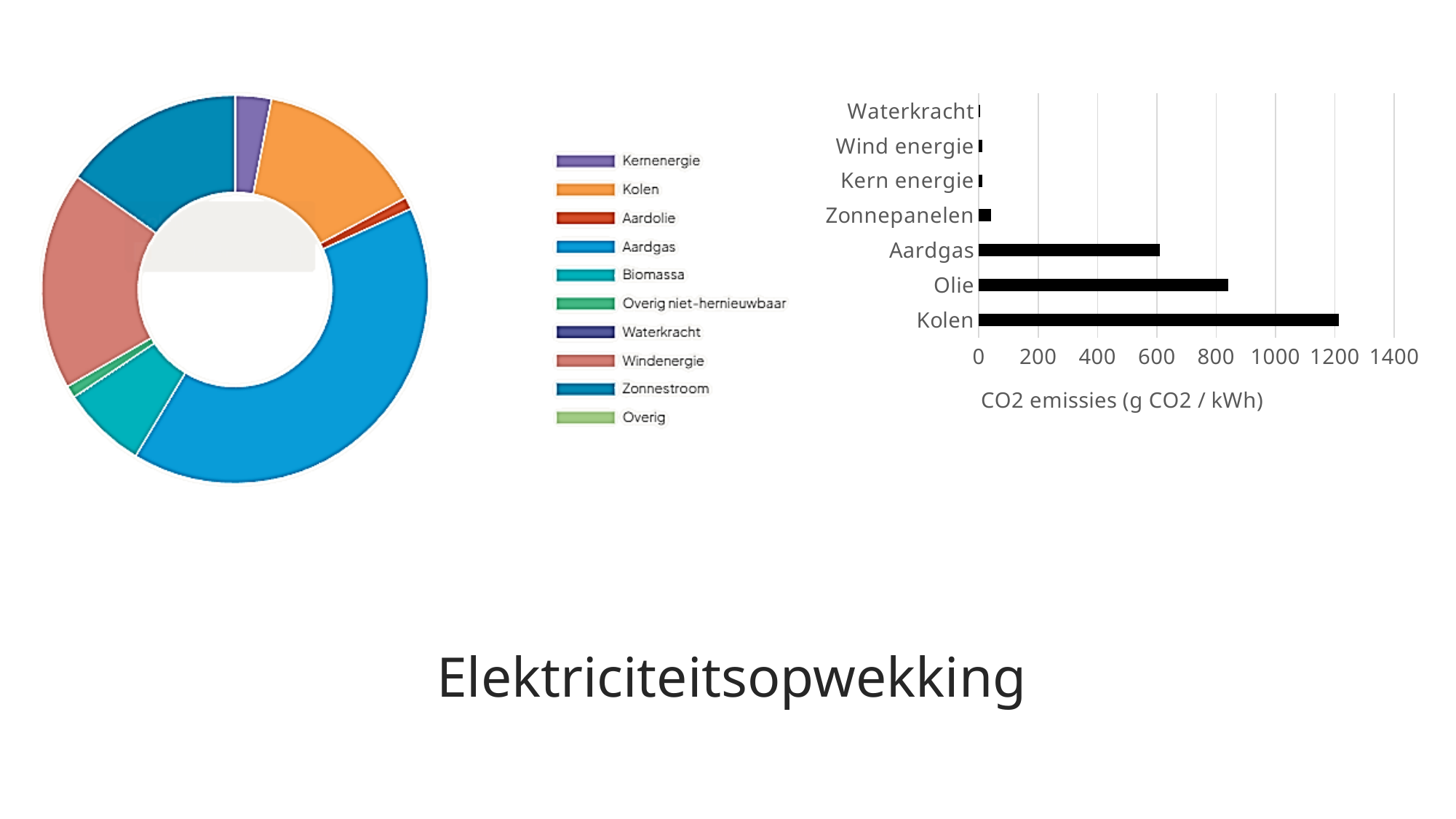
How many categories does the bar chart on the right show? 7 In the bar chart on the right, is the value for Zonnepanelen greater or less than 200? less In the bar chart on the right, which is larger, the value for Olie or the value for Aardgas? Olie In the bar chart on the right, which category has the highest CO2 emissions? Kolen In the pie chart on the left, which slice is larger, Windenergie or Biomassa? Windenergie What is the x-axis title of the bar chart on the right? CO2 emissies (g CO2 / kWh) What kind of chart is the chart on the right of the slide? bar chart In the bar chart on the right, is the value for Kolen greater or less than 1000? greater In the bar chart on the right, is the value for Olie greater or less than 800? greater What kind of chart is the chart on the left of the slide? pie chart In the pie chart on the left, which category has the largest slice? Aardgas How many entries does the legend of the pie chart on the left list? 10